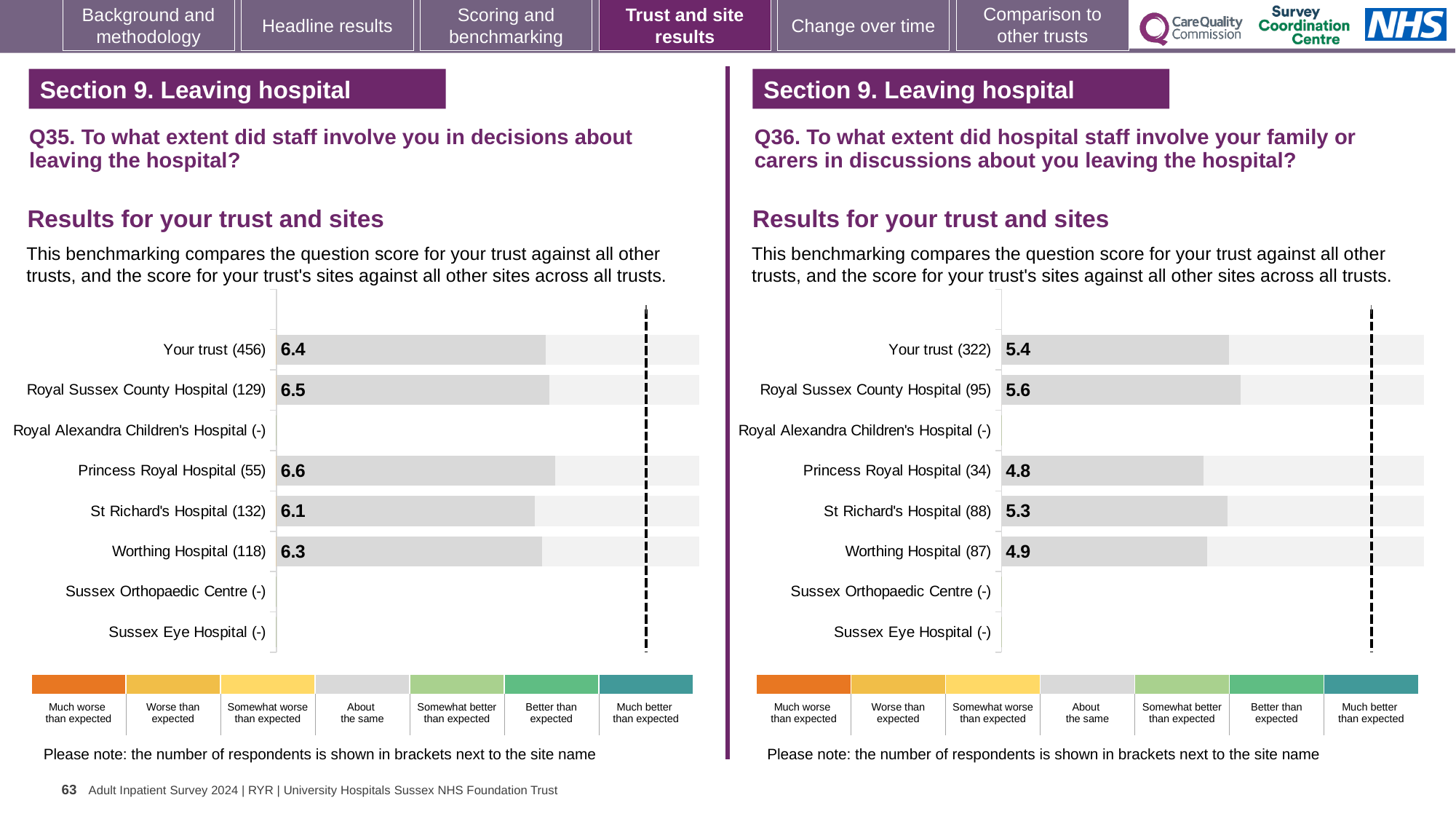
In the Q36 chart on the right, which is larger: the score for Your trust (322) or the score for Worthing Hospital (87)? Your trust (322) What kind of chart is used in the Q35 chart on the left? Bar chart In the Q35 chart on the left, what is the score for Your trust (456)? 6.4 In the Q35 chart on the left, how many rows have a score shown? 5 In the Q36 chart on the right, which site has the lowest score? Princess Royal Hospital (34) In the Q35 chart on the left, which site has the highest score? Princess Royal Hospital (55) In the Q36 chart on the right, what is the difference between the scores for Your trust (322) and Princess Royal Hospital (34)? 0.6 In the Q36 chart on the right, what is the score for St Richard's Hospital (88)? 5.3 In the Q35 chart on the left, what is the difference between the scores for Royal Sussex County Hospital (129) and Worthing Hospital (118)? 0.2 In the Q35 chart on the left, which site has the lowest score? St Richard's Hospital (132) How many categories does the colour key below the Q36 chart on the right list? 7 In the Q36 chart on the right, which site has the highest score? Royal Sussex County Hospital (95)